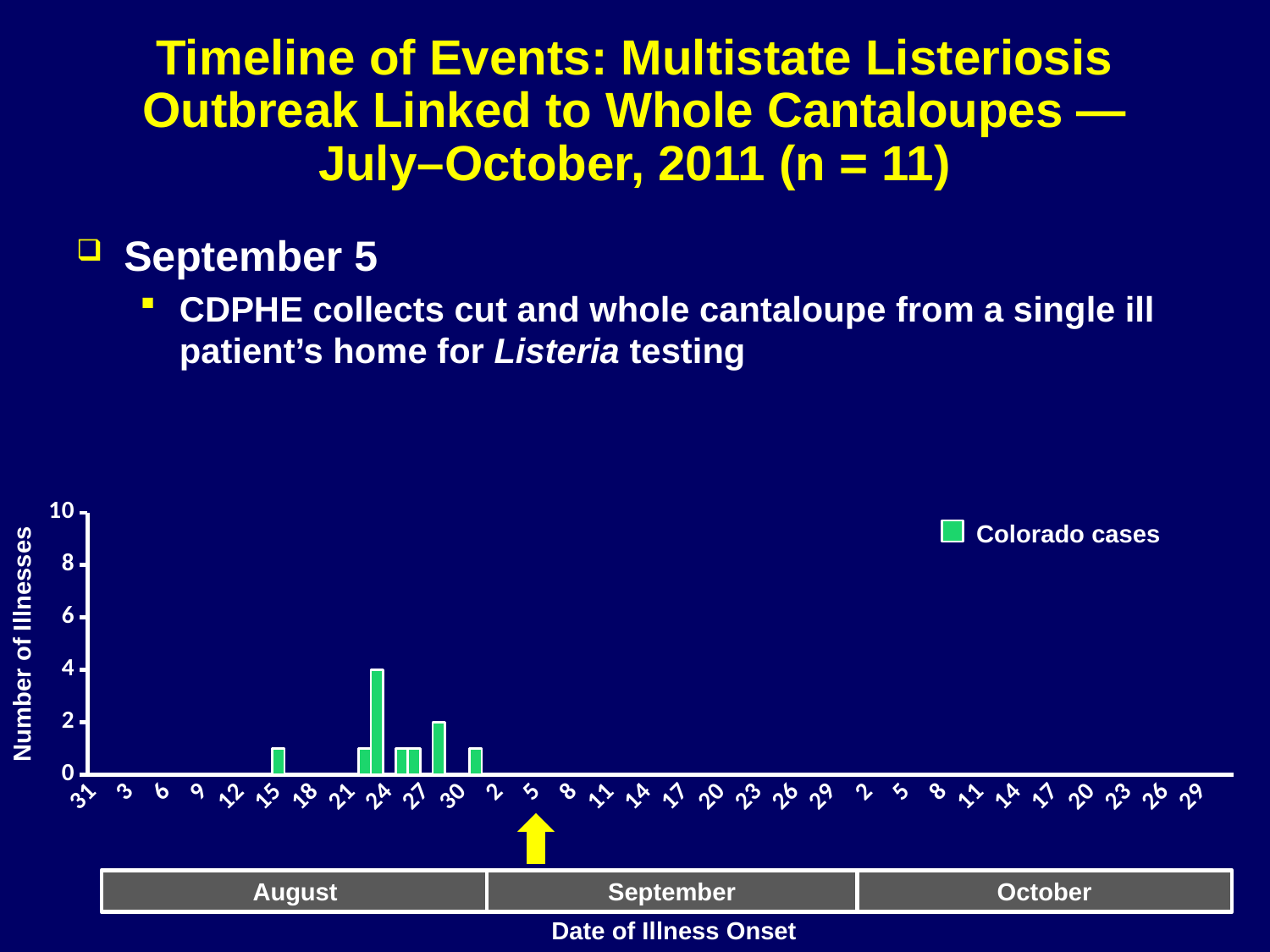
In which month do all of the plotted illness onset dates fall? August Is the value of the bar at August 15 greater or less than 2? less What kind of chart is shown on the slide? bar chart Is the value of the tallest bar greater or less than 6? less What is the highest value shown on the vertical axis of the chart? 10 How many bars are plotted in the chart? 7 What is the label of the vertical axis of the chart? Number of Illnesses What is the value of the tallest bar in the chart? 4 How many series does the chart legend list? 1 Is the value of the tallest bar greater or less than 2? greater What is the name of the series shown in the chart legend? Colorado cases